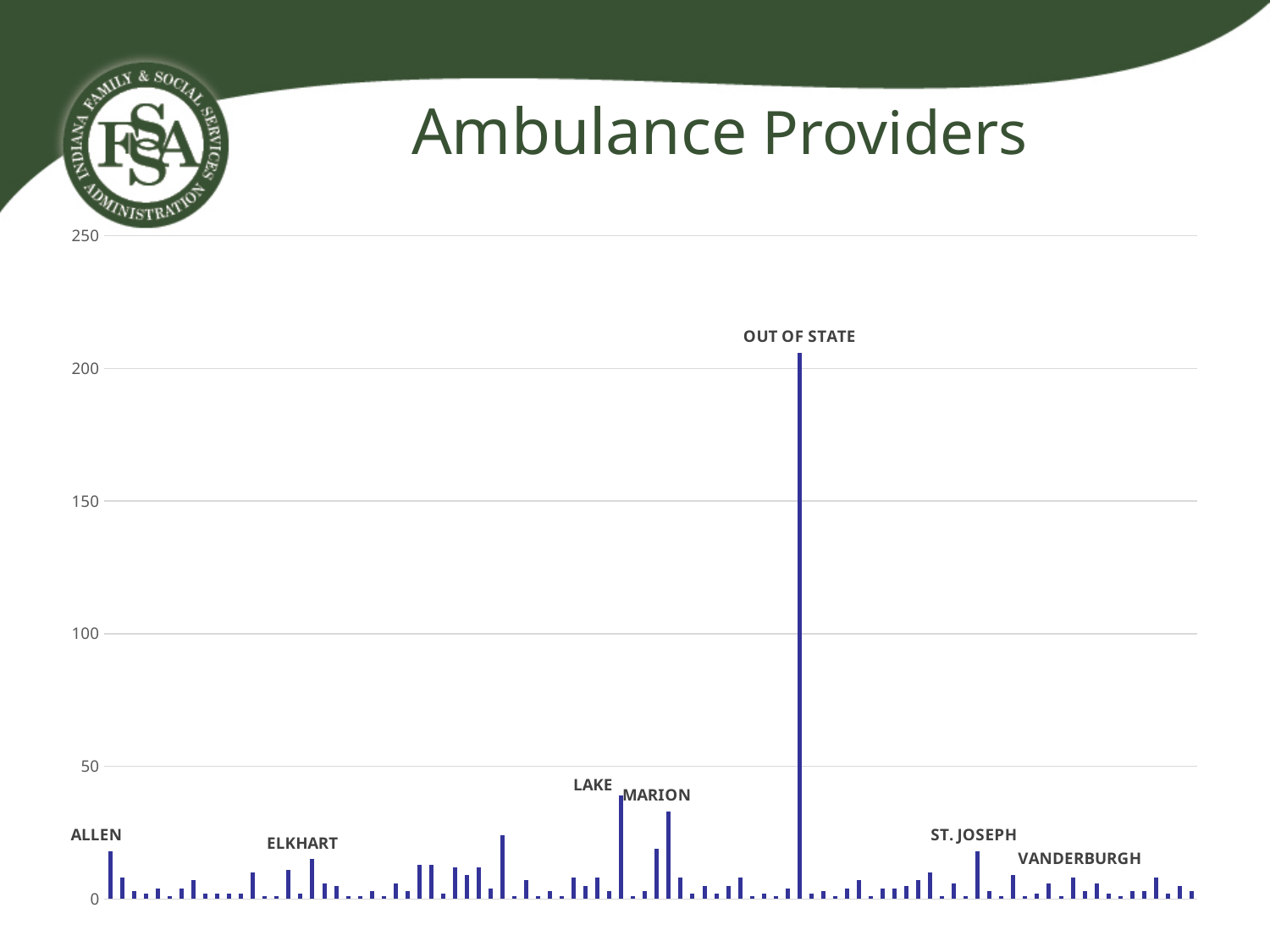
Which is larger, the value for OUT OF STATE or the value for LAKE? OUT OF STATE Among the labeled categories, which has the lowest value? VANDERBURGH Which category has the highest value in the chart? OUT OF STATE Is the value for ALLEN greater or less than 50? less What is the title of the chart? Ambulance Providers Which is larger, the value for LAKE or the value for MARION? LAKE Is the value for OUT OF STATE greater or less than 200? greater Is the value for MARION greater or less than 100? less What kind of chart is shown on the slide? bar chart Which is larger, the value for ALLEN or the value for VANDERBURGH? ALLEN What is the highest value shown on the vertical axis? 250